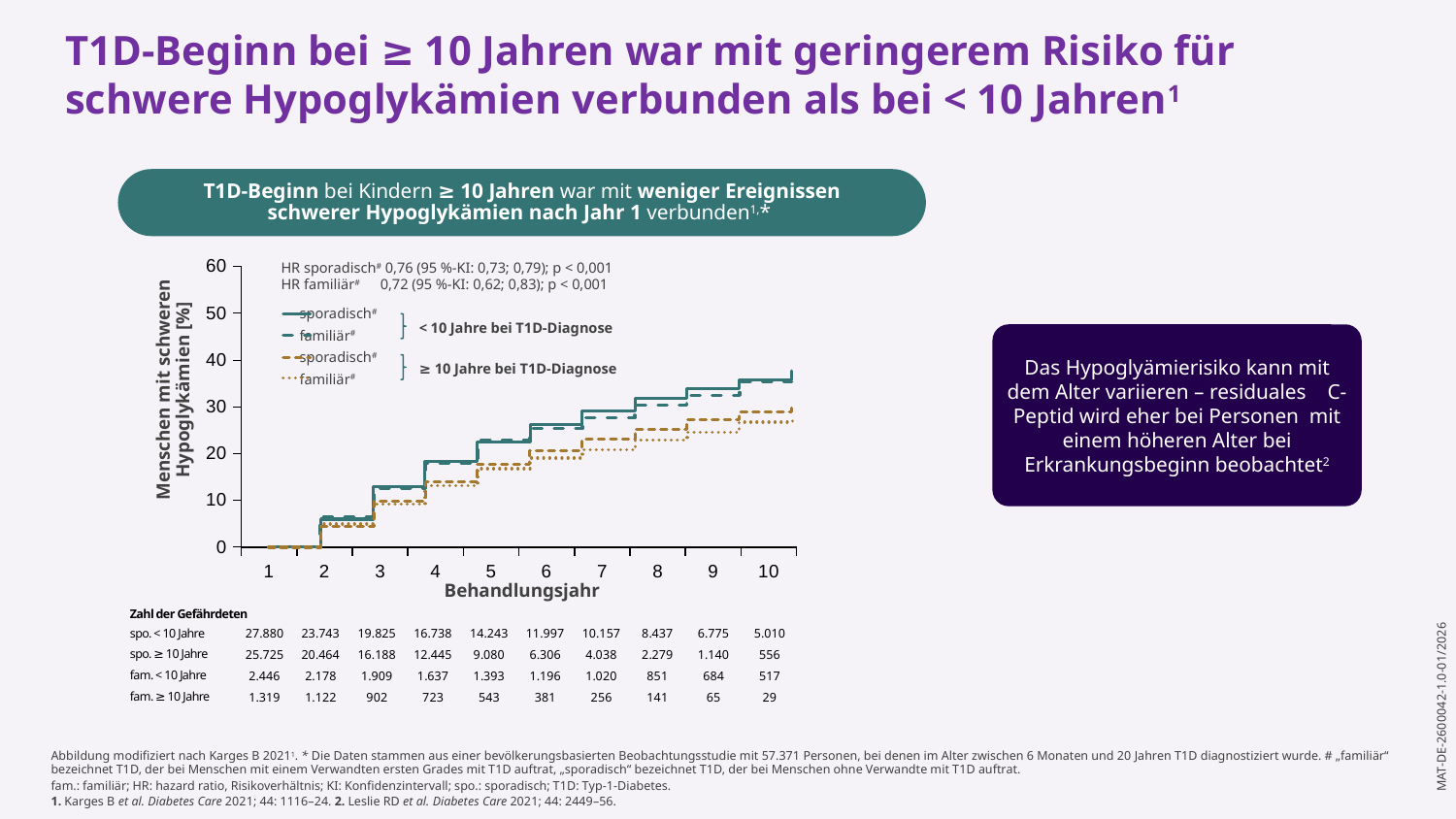
In the 'Zahl der Gefährdeten' table, how many people are at risk in the 'spo. < 10 Jahre' group at treatment year 1? 27.880 How many series does the chart's legend list? 4 In the 'Zahl der Gefährdeten' table, how many people are at risk in the 'fam. ≥ 10 Jahre' group at treatment year 10? 29 How many treatment years (Behandlungsjahr) are shown on the x axis? 10 What kind of chart is shown on the slide? line chart Is the value for 'sporadisch, < 10 Jahre bei T1D-Diagnose' at treatment year 10 greater or less than 30? greater What is the label of the y axis? Menschen mit schweren Hypoglykämien [%] Do the plotted values rise or fall as the treatment year increases? rise At treatment year 10, which is larger: the value for 'sporadisch, < 10 Jahre' or 'sporadisch, ≥ 10 Jahre'? sporadisch, < 10 Jahre What hazard ratio is given for 'sporadisch' in the chart annotation? 0,76 Is the value for 'familiär, ≥ 10 Jahre bei T1D-Diagnose' at treatment year 10 greater or less than 30? less What hazard ratio is given for 'familiär' in the chart annotation? 0,72